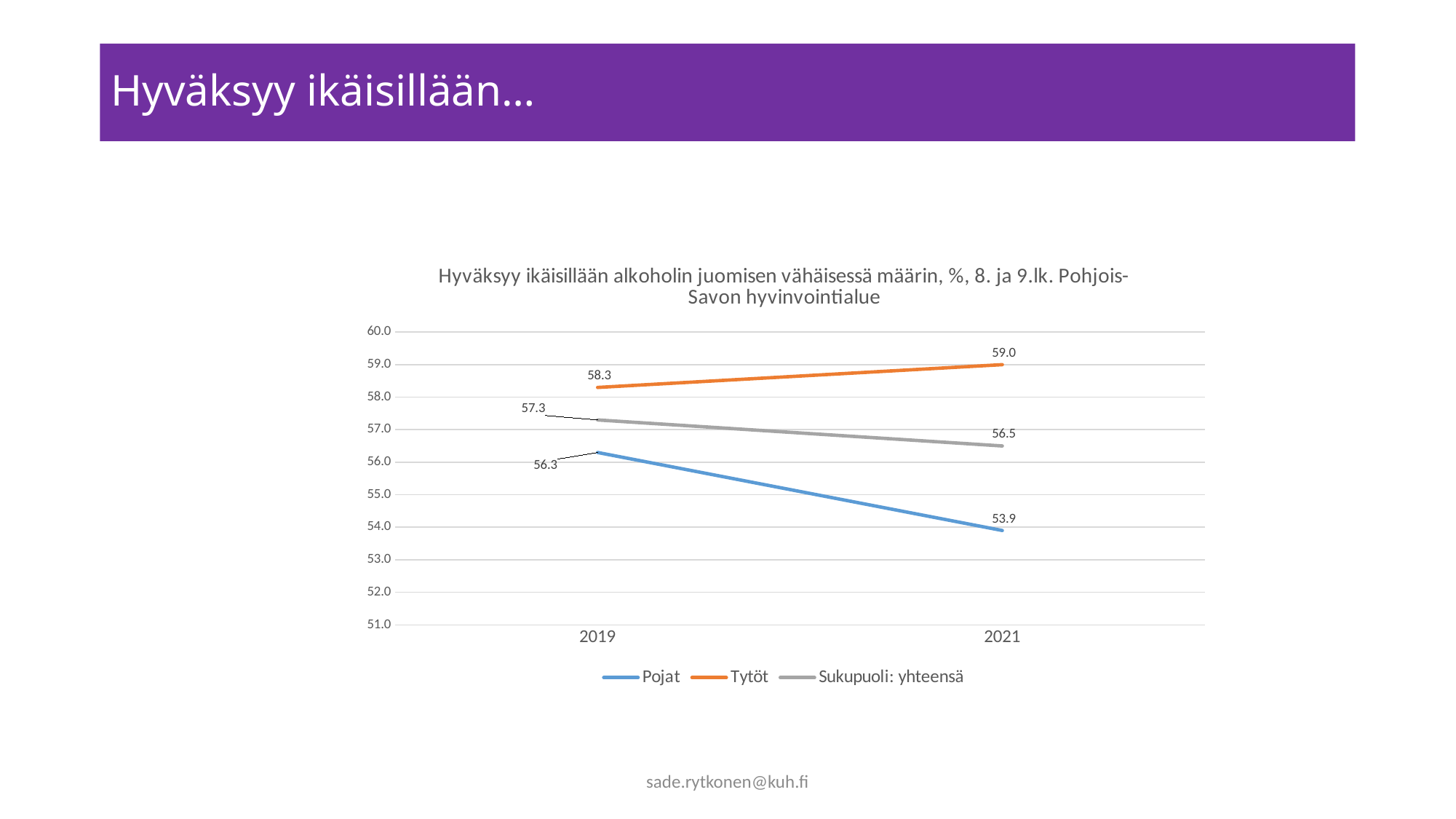
What is the difference between the Tytöt value and the Pojat value in 2021? 5.1 What kind of chart is shown on the slide? line chart Which series has the highest value in 2021? Tytöt Which series has the lowest value in 2019? Pojat How many series does the legend list? 3 Does the value for Pojat rise or fall from 2019 to 2021? fall What is the value for Sukupuoli: yhteensä in 2019? 57.3 How many years are shown on the x axis? 2 What is the value for Tytöt in 2021? 59.0 Which is larger in 2019: the value for Tytöt or the value for Sukupuoli: yhteensä? Tytöt What is the value for Pojat in 2019? 56.3 What is the value for Pojat in 2021? 53.9